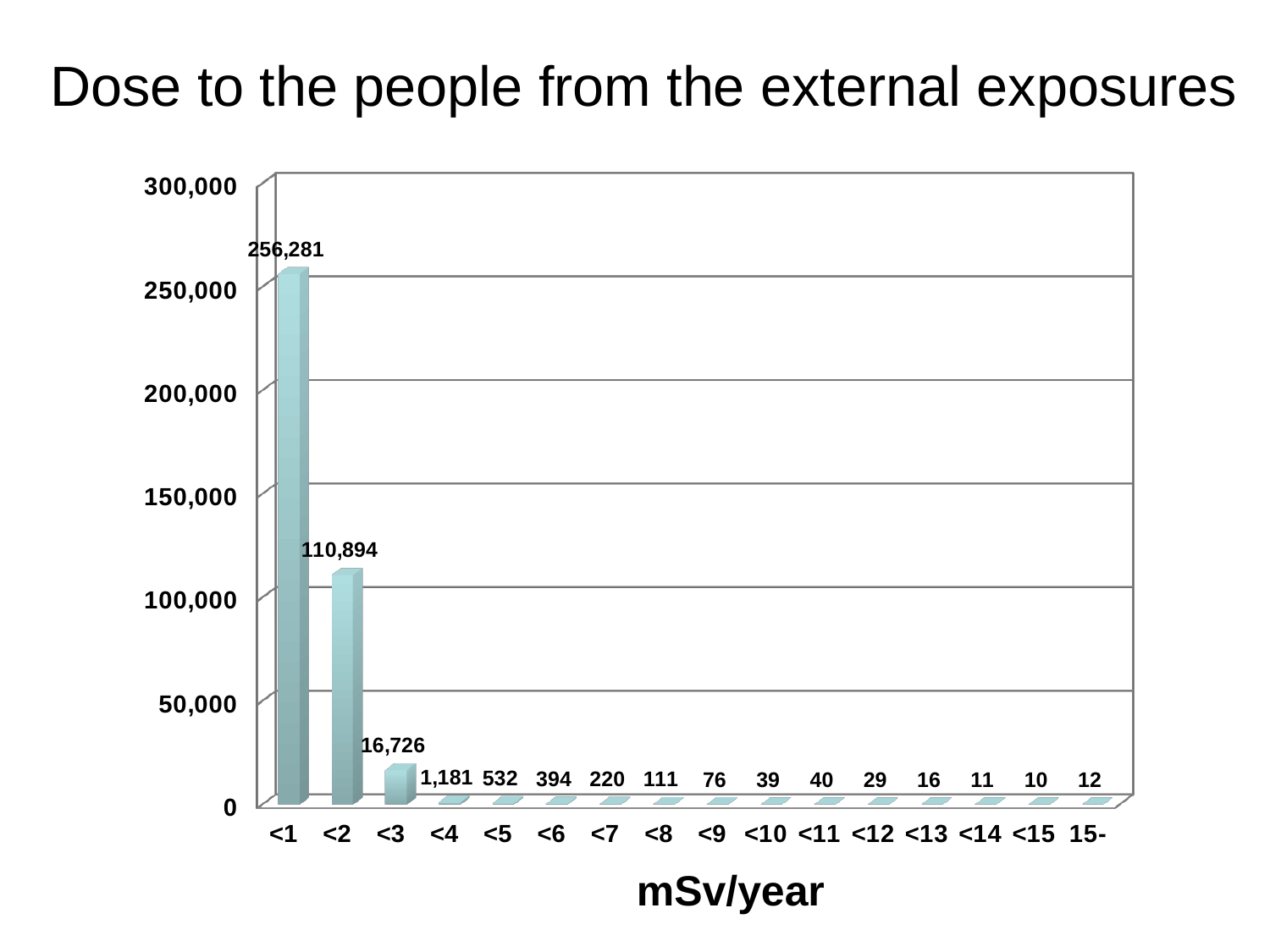
What kind of chart is shown on the slide? bar chart Which category has the lowest value? <15 Which is larger, the value for <10 or the value for <11? <11 What is the value for the <3 mSv/year category? 16,726 How many categories are shown on the x axis? 16 What is the value for the 15- category? 12 What is the x-axis label of the chart? mSv/year What is the value for the <1 mSv/year category? 256,281 Is the value for <1 greater or less than 250,000? greater Which category has the highest value? <1 What is the difference between the values for <1 and <2? 145,387 What is the value for the <2 mSv/year category? 110,894